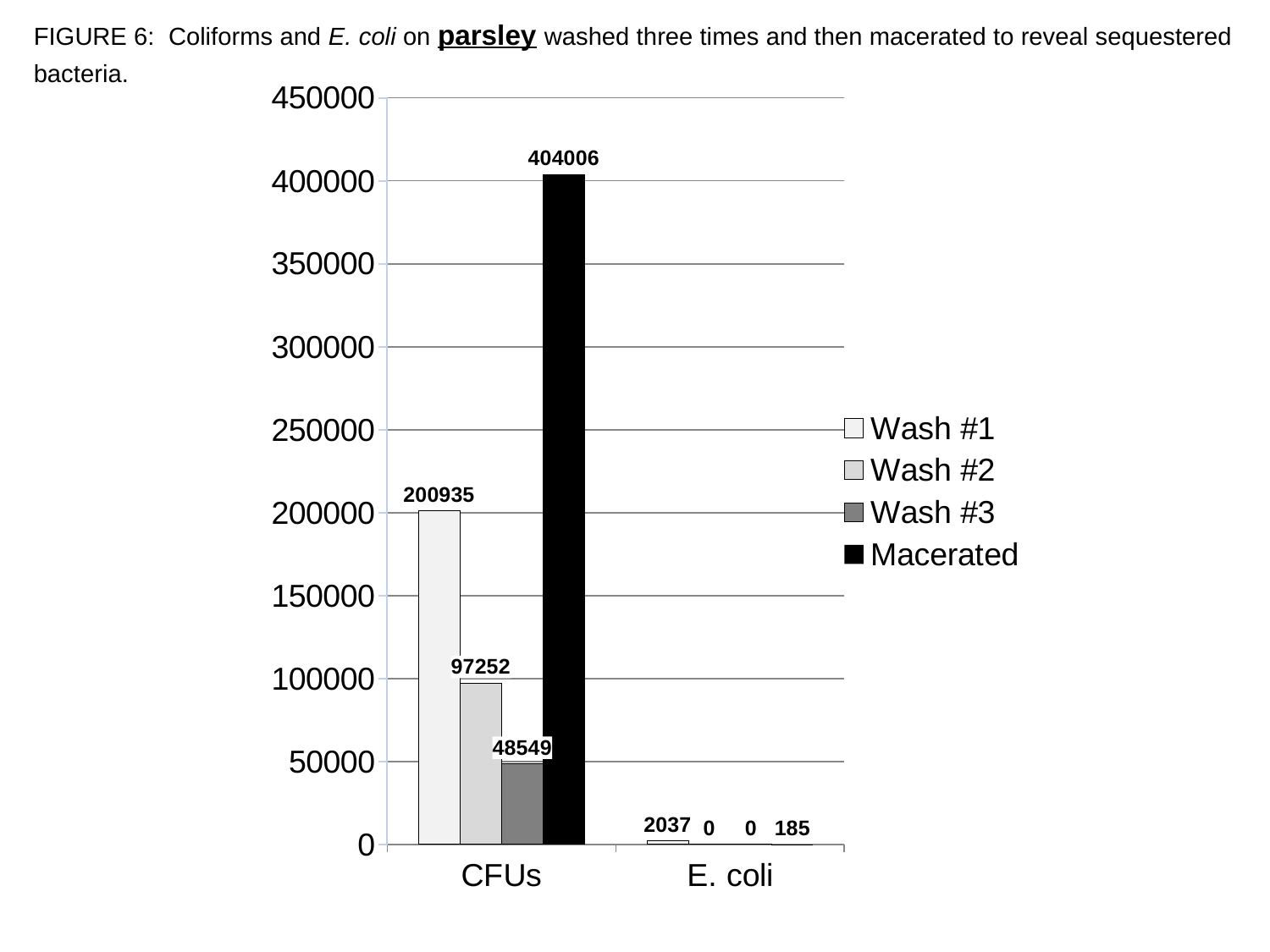
How many categories are shown on the x axis? 2 What is the Wash #2 value for E. coli? 0 How many series does the legend list? 4 What is the difference between the Wash #1 and Wash #2 values for CFUs? 103683 Which series has the highest value for CFUs? Macerated What is the Macerated value for CFUs? 404006 Which is larger for E. coli: Wash #1 or Macerated? Wash #1 What is the Macerated value for E. coli? 185 Is the Wash #3 value for CFUs greater or less than 50000? less What kind of chart is shown? bar chart Which series has the lowest value for CFUs? Wash #3 What is the Wash #1 value for CFUs? 200935